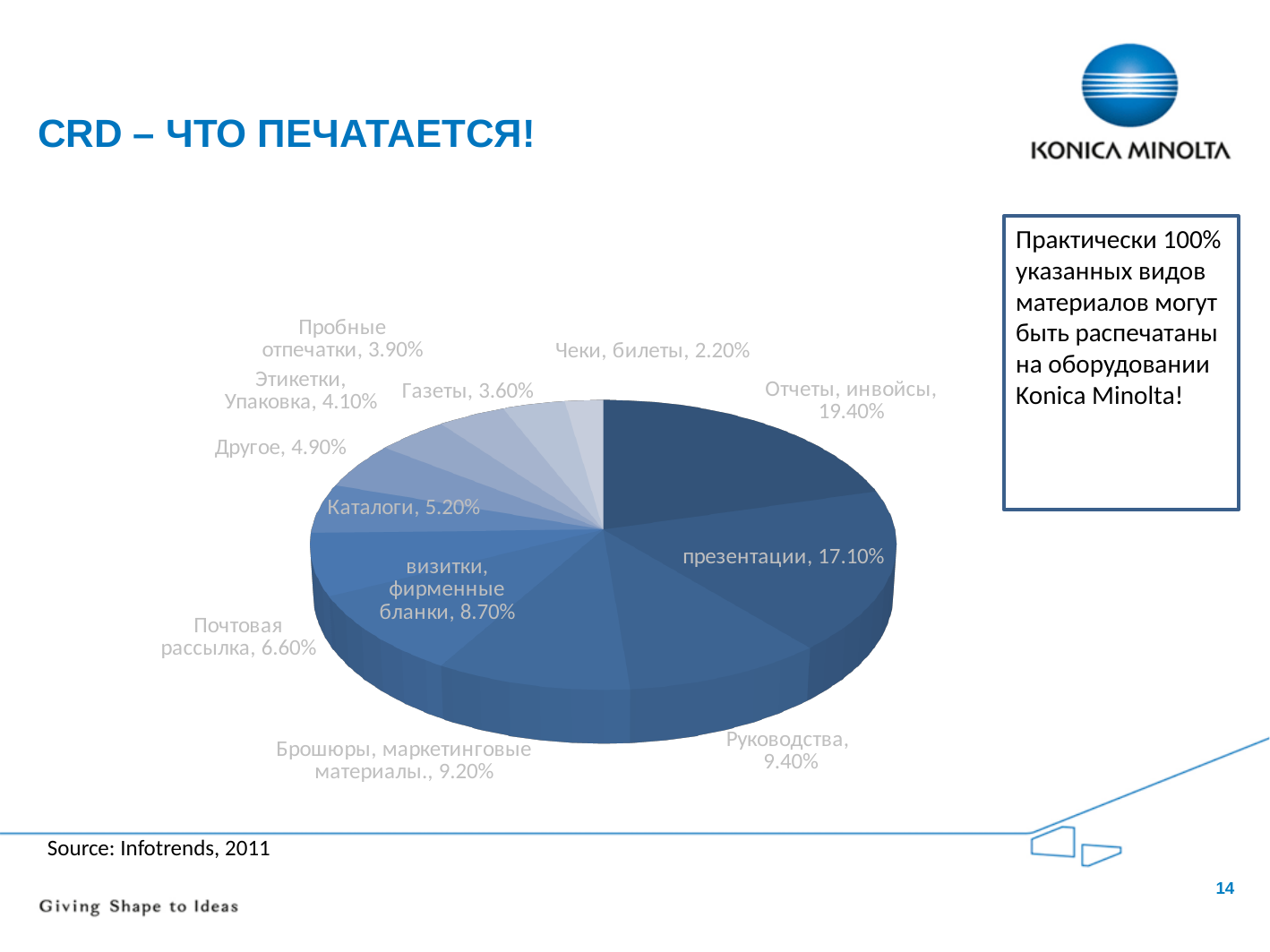
What is the source cited for the chart data? Infotrends, 2011 What is the difference between the values for визитки, фирменные бланки and Газеты? 5.10% What value is shown for Почтовая рассылка? 6.60% What type of chart is shown on the slide? Pie chart What is the difference between the values for Отчеты, инвойсы and презентации? 2.30% How many categories are shown in the pie chart? 12 What share of the pie is labelled for Отчеты, инвойсы? 19.40% What value is shown for презентации? 17.10% Which category has the largest slice of the pie? Отчеты, инвойсы Which category has the smallest slice of the pie? Чеки, билеты Which is larger: the value for Руководства or the value for Каталоги? Руководства What value is shown for Чеки, билеты? 2.20%